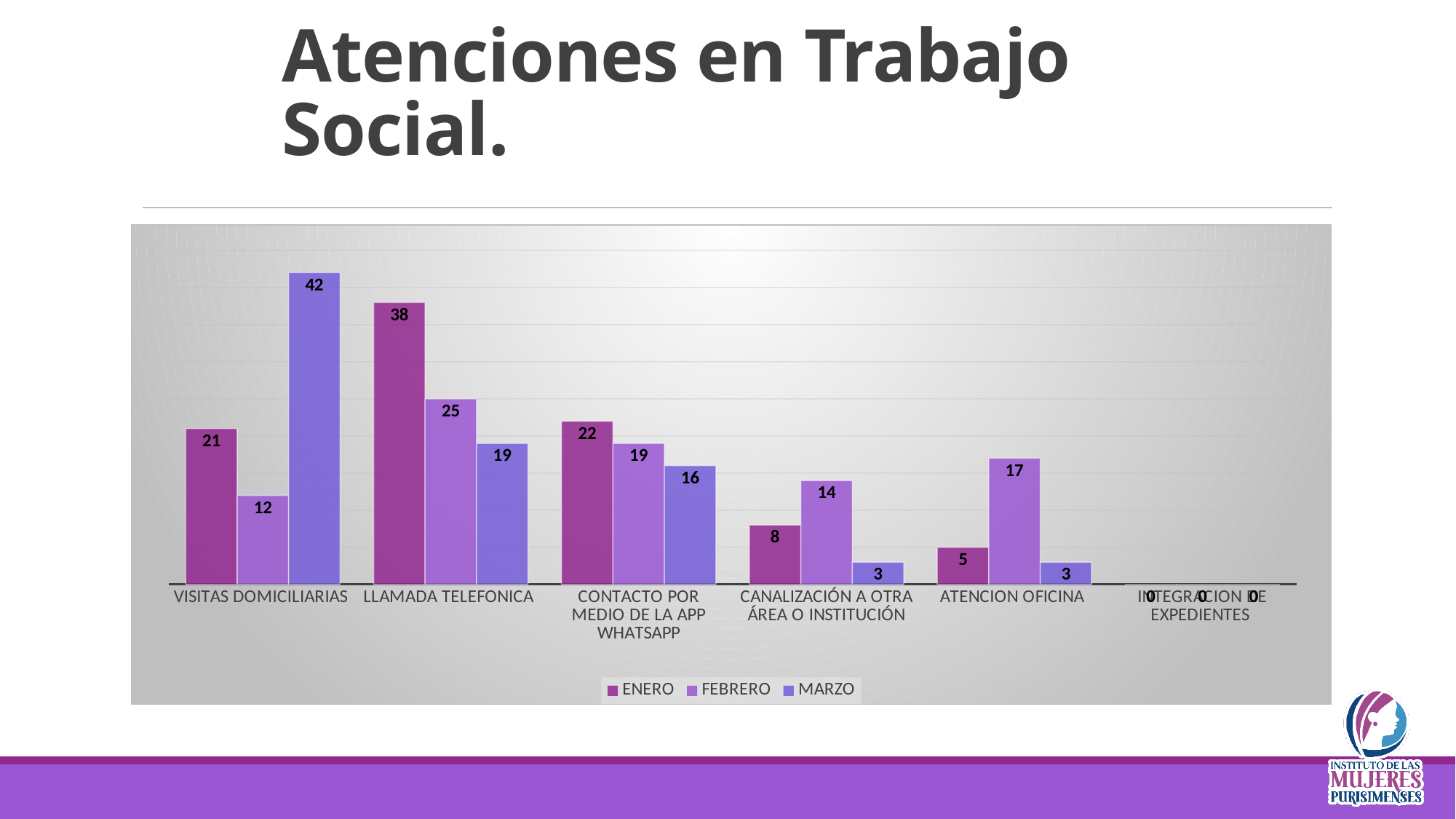
What is the ENERO value for LLAMADA TELEFONICA? 38 What kind of chart is shown on the slide? Bar chart What is the difference between the ENERO and FEBRERO values for VISITAS DOMICILIARIAS? 9 What is the total of the ENERO, FEBRERO and MARZO values for ATENCION OFICINA? 25 How many series does the legend list? 3 Which is larger for CANALIZACIÓN A OTRA ÁREA O INSTITUCIÓN, the ENERO value or the FEBRERO value? FEBRERO Which category has the lowest FEBRERO value? INTEGRACION DE EXPEDIENTES How many categories are shown on the x axis? 6 Which category has the highest ENERO value? LLAMADA TELEFONICA What is the MARZO value for VISITAS DOMICILIARIAS? 42 What is the MARZO value for CONTACTO POR MEDIO DE LA APP WHATSAPP? 16 What is the FEBRERO value for ATENCION OFICINA? 17